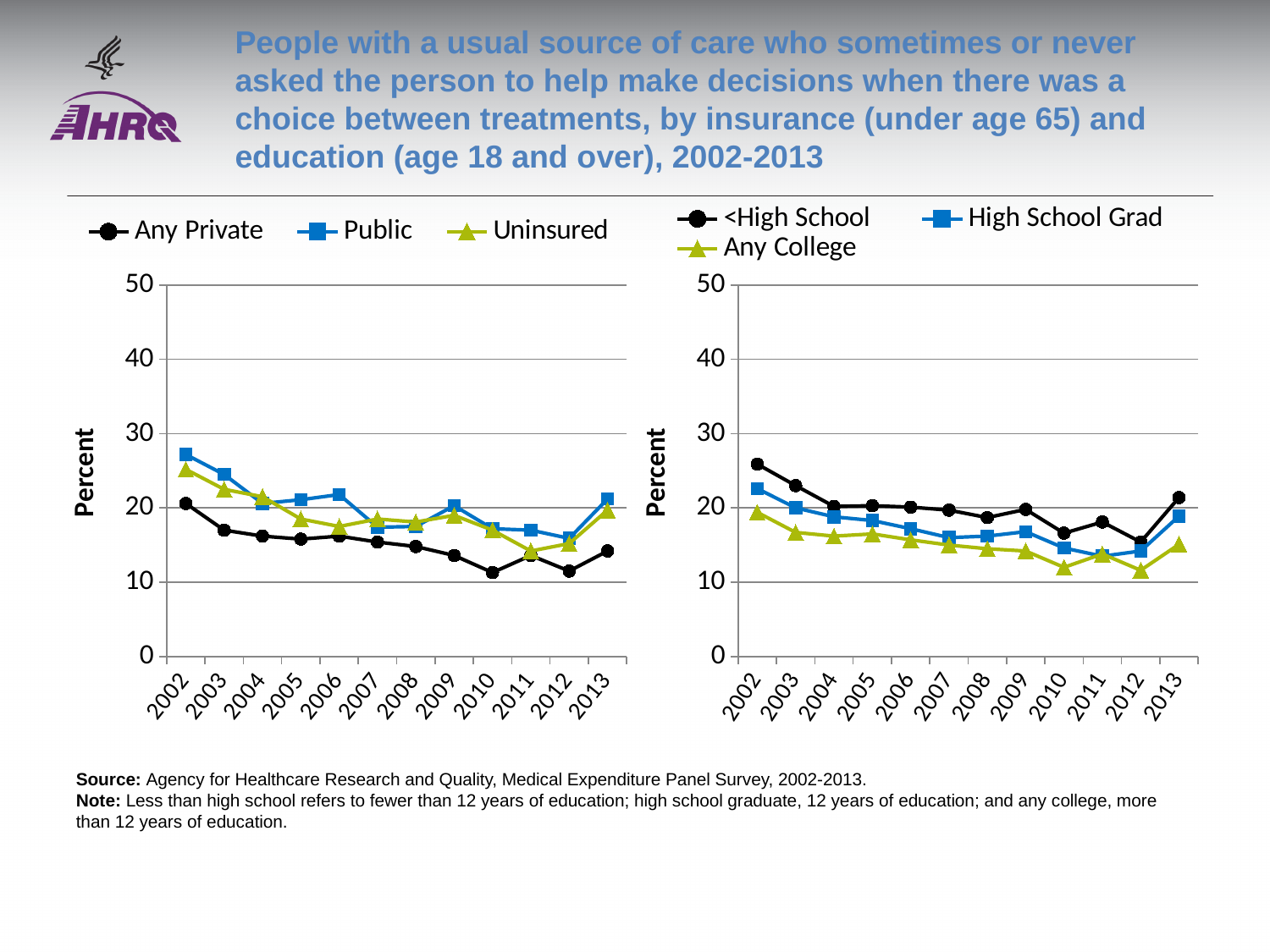
In the right chart (by education), is the value for <High School in 2002 greater or less than 20? greater In the left chart (by insurance), is the value for Public in 2002 greater or less than 20? greater What kind of chart is the left chart (by insurance)? line chart In the left chart (by insurance), which series has the highest value in 2002? Public How many years are plotted along the x axis of the left chart (by insurance)? 12 In the right chart (by education), which series has the lowest value in 2002? Any College In the left chart (by insurance), is the value for Any Private in 2010 greater or less than 20? less In the right chart (by education), does the <High School series generally rise or fall from 2002 to 2012? fall How many series does the legend of the right chart (by education) list? 3 In the left chart (by insurance), which is larger in 2010, Any Private or Public? Public What is the y-axis label on the left chart (by insurance)? Percent